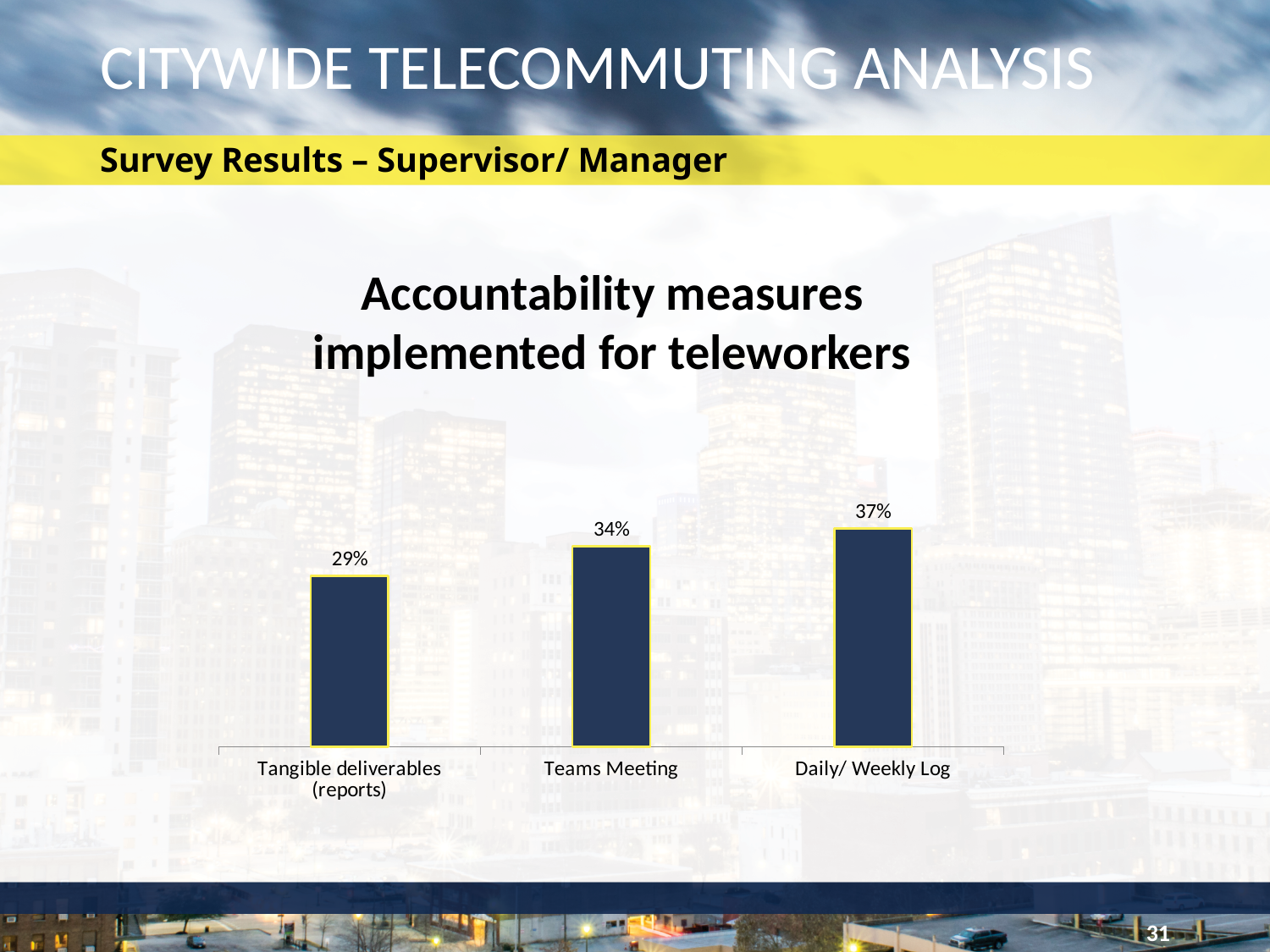
What percentage is shown for Tangible deliverables (reports)? 29% Which is larger, the value for Teams Meeting or the value for Daily/ Weekly Log? Daily/ Weekly Log Do the values rise or fall from left to right across the categories? Rise What type of chart is used to show the accountability measures? Bar chart What is the difference in percentage points between Teams Meeting and Tangible deliverables (reports)? 5 What percentage is shown for Teams Meeting? 34% How many accountability measures are shown in the chart? 3 What is the difference in percentage points between Daily/ Weekly Log and Tangible deliverables (reports)? 8 What percentage is shown for Daily/ Weekly Log? 37% Which accountability measure has the highest percentage? Daily/ Weekly Log Which accountability measure has the lowest percentage? Tangible deliverables (reports) What is the title of the chart? Accountability measures implemented for teleworkers